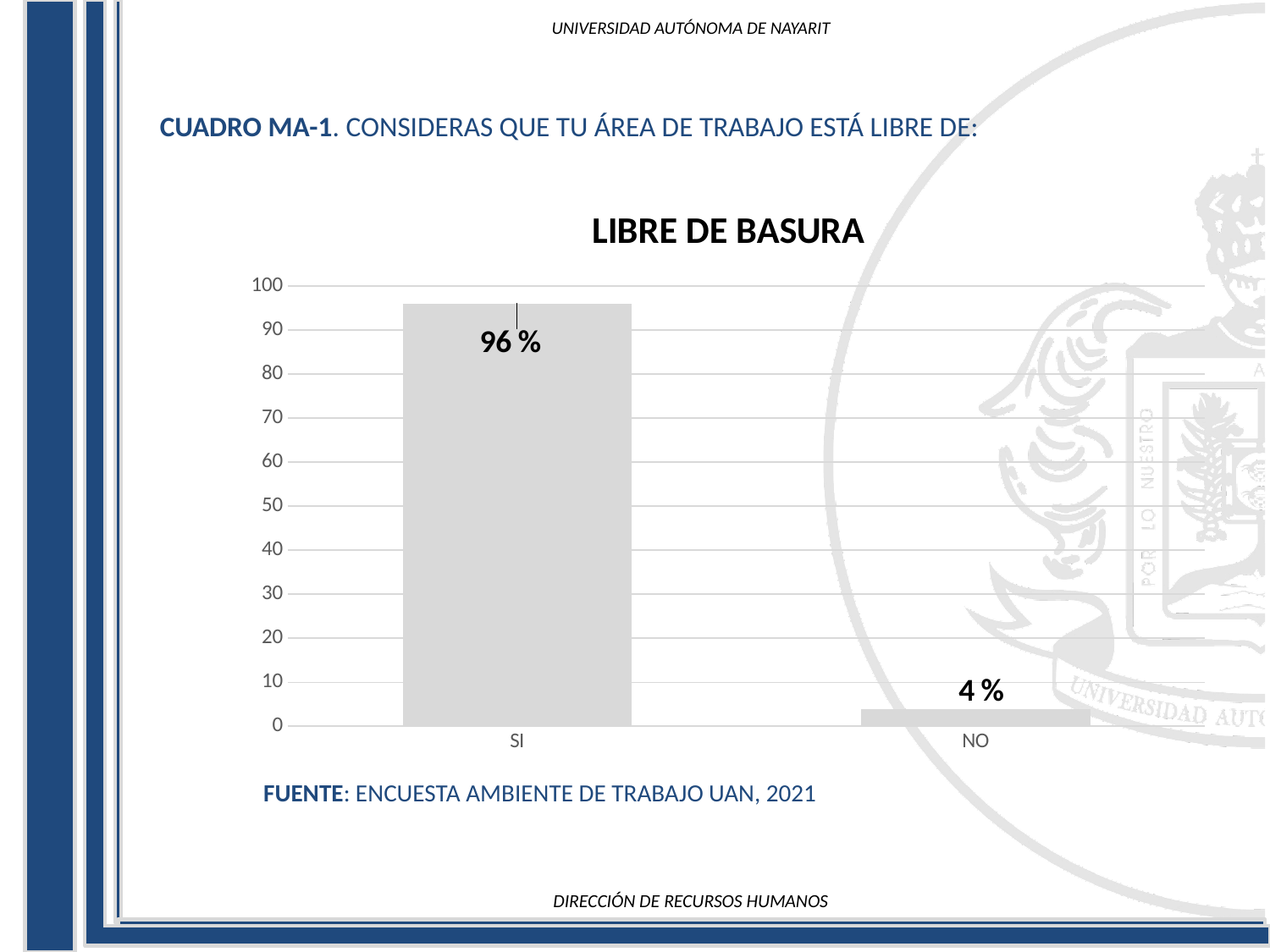
What is the value for NO? 4 % What is the source cited below the chart? ENCUESTA AMBIENTE DE TRABAJO UAN, 2021 Which category has the highest value? SI Which category has the lowest value? NO What is the value for SI? 96 % Which is larger, the value for SI or the value for NO? SI What is the difference between the values for SI and NO? 92 % Is the value for SI greater or less than 90? greater How many categories are shown on the x axis? 2 What kind of chart is shown? bar chart What is the title of the chart? LIBRE DE BASURA Is the value for NO greater or less than 10? less